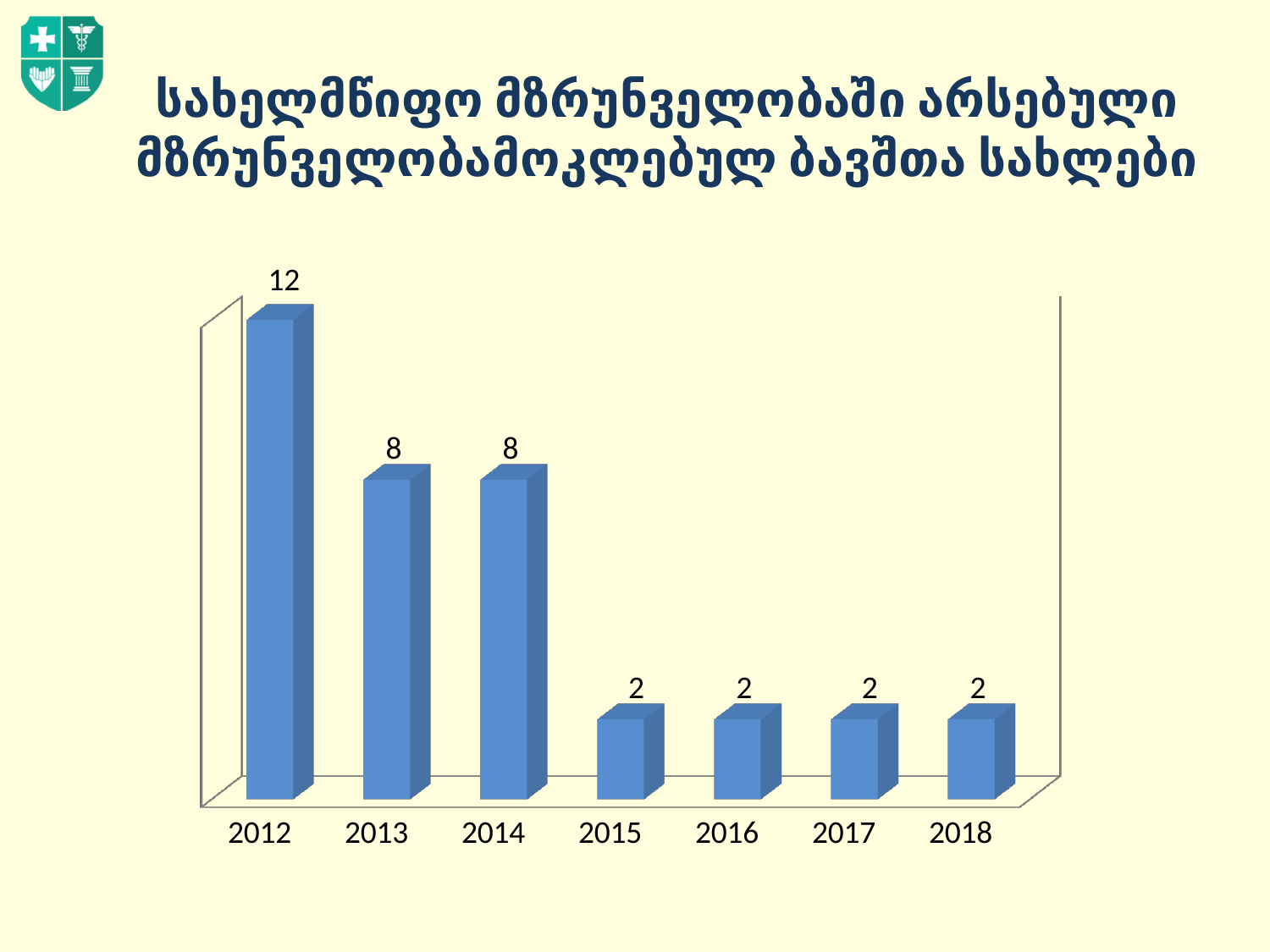
How many years have a value of 2? 4 What is the difference between the values for 2014 and 2015? 6 What kind of chart is shown on the slide? bar chart What is the value for 2017? 2 What is the value for 2014? 8 What colour are the bars in the chart? blue What is the difference between the values for 2012 and 2013? 4 Which year has the highest value? 2012 What is the value for 2012? 12 How many years are shown on the x axis? 7 Which is larger, the value for 2013 or the value for 2016? 2013 Do the values generally rise or fall from 2012 to 2018? fall